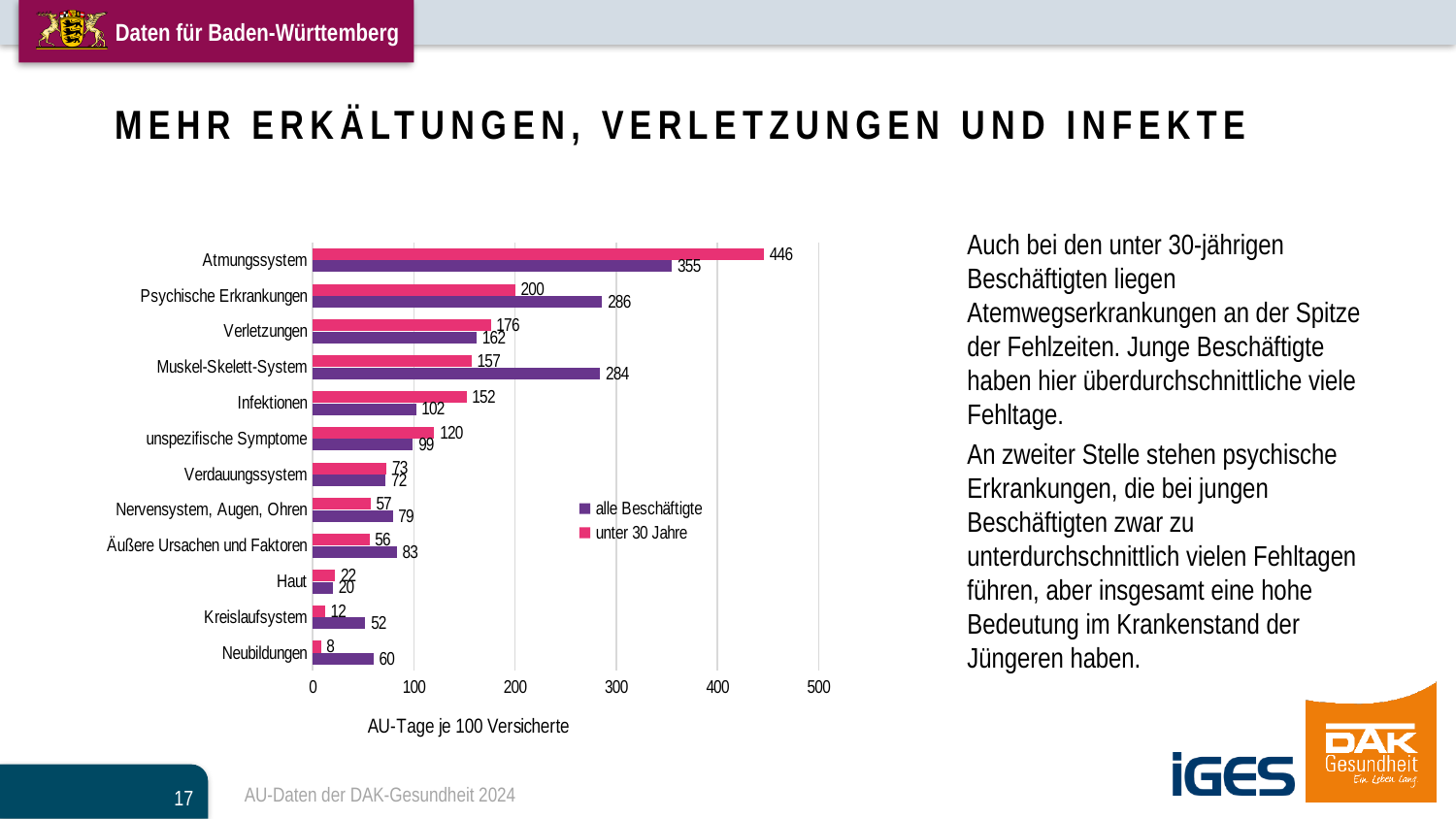
Is the value for "alle Beschäftigte" in the Atmungssystem category greater or less than 300? greater Which category has the lowest value for "unter 30 Jahre"? Neubildungen What is the value for "unter 30 Jahre" in the Kreislaufsystem category? 12 What is the value for "alle Beschäftigte" in the Psychische Erkrankungen category? 286 What is the difference between "alle Beschäftigte" and "unter 30 Jahre" in the Muskel-Skelett-System category? 127 Which category has the highest value for "unter 30 Jahre"? Atmungssystem What type of chart is shown on the slide? bar chart How many categories are shown on the y axis of the chart? 12 What is the value for "unter 30 Jahre" in the Atmungssystem category? 446 How many series does the chart legend list? 2 What is the label of the x axis of the chart? AU-Tage je 100 Versicherte In the Infektionen category, which series has the larger value, "alle Beschäftigte" or "unter 30 Jahre"? unter 30 Jahre